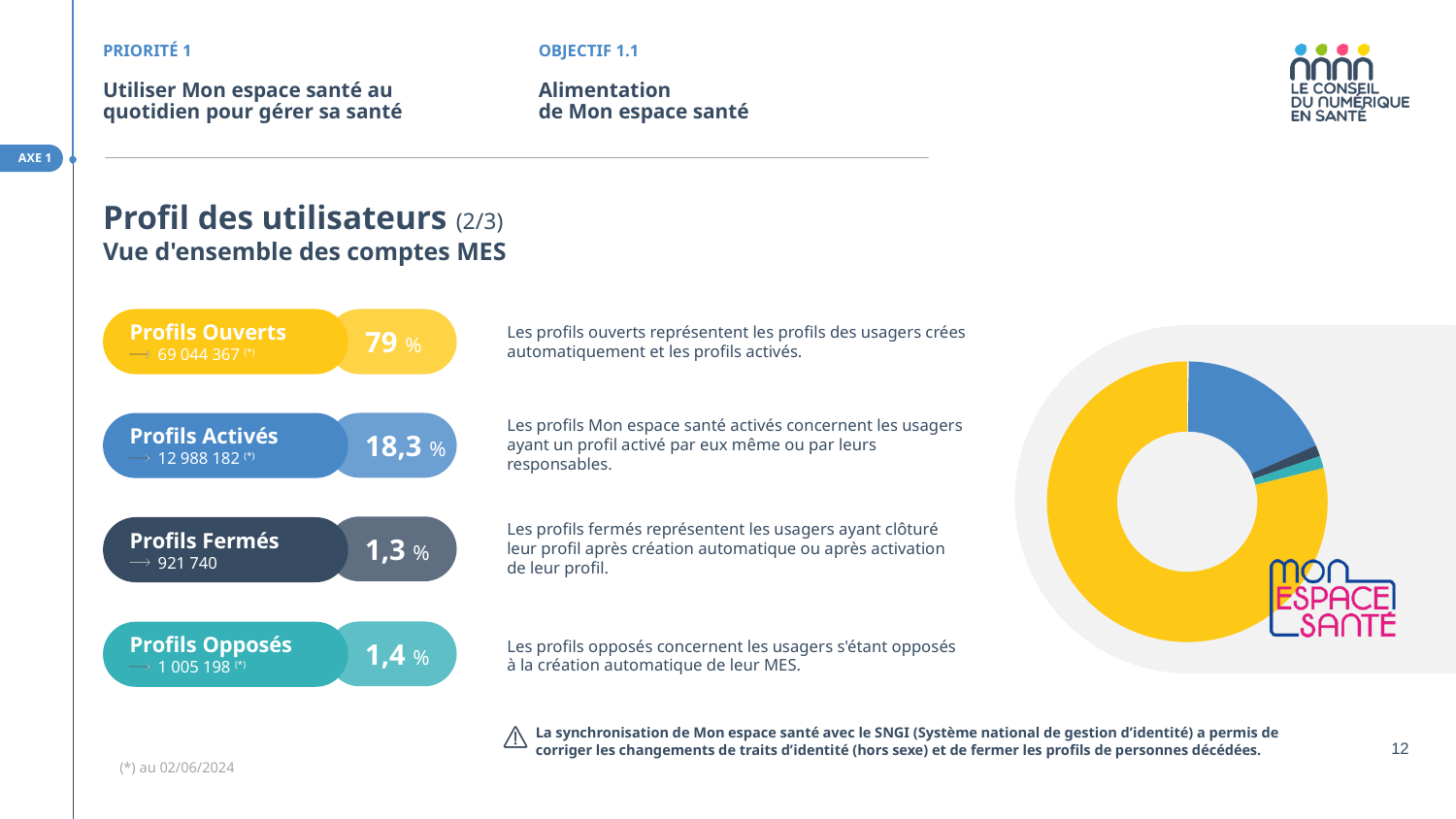
What share of MES accounts do the Profils Ouverts represent? 79 % What percentage is shown for Profils Fermés? 1,3 % What colour is the largest slice of the donut chart? yellow What is the difference in percentage points between Profils Ouverts (79 %) and Profils Activés (18,3 %)? 60,7 points Which is larger, the share of Profils Ouverts or the share of Profils Activés? Profils Ouverts Which profile category corresponds to the largest slice of the donut chart? Profils Ouverts How many Profils Activés are reported on the slide? 12 988 182 What percentage is shown for Profils Activés? 18,3 % What kind of chart is shown on the right of the slide? pie chart (donut) How many Profils Ouverts are reported on the slide? 69 044 367 What percentage is shown for Profils Opposés? 1,4 %